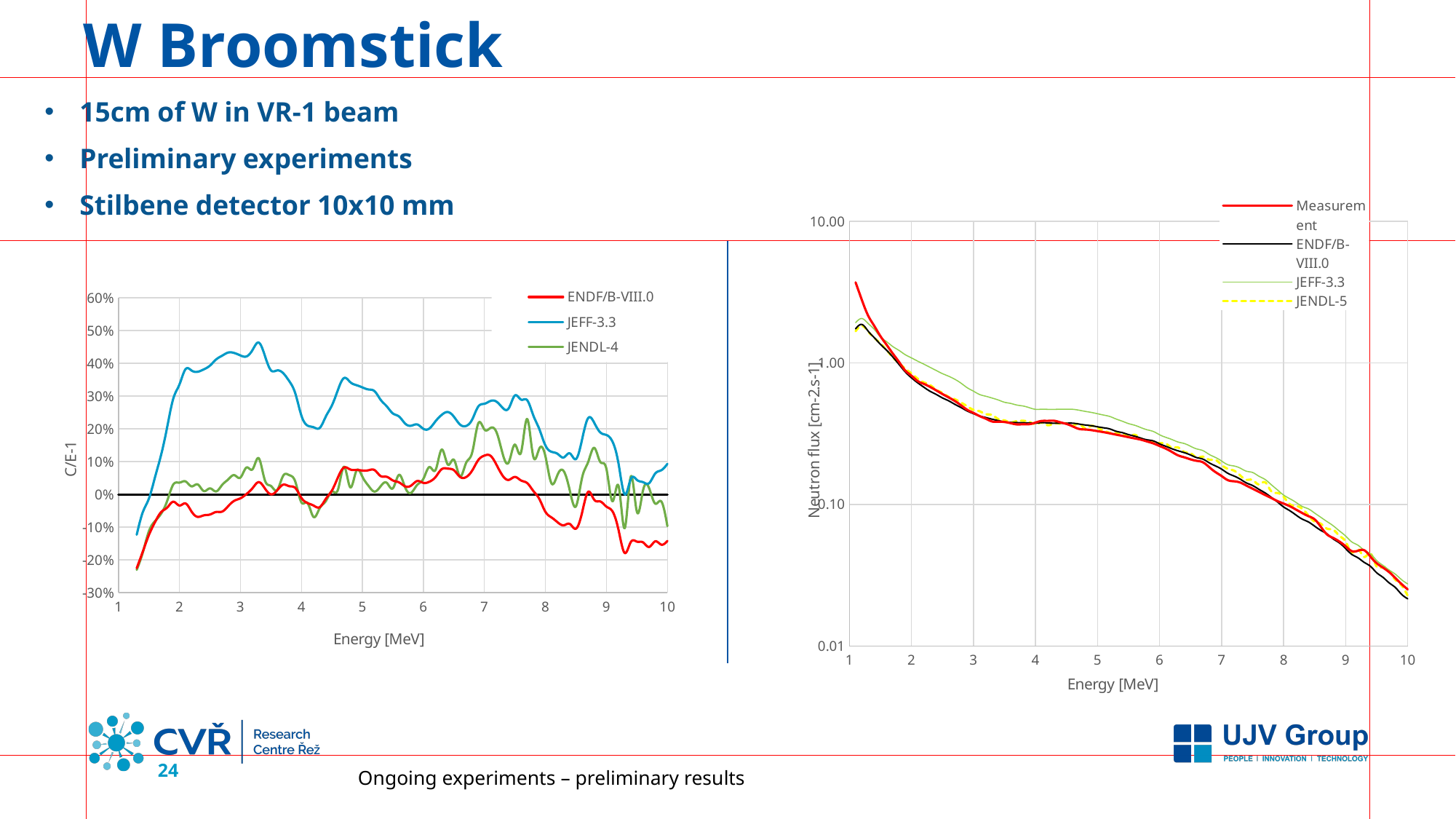
In the left chart (C/E-1), which series has the highest values over most of the energy range? JEFF-3.3 What is the y-axis title of the left chart? C/E-1 In the right chart (Neutron flux), at 5 MeV, which is larger: JEFF-3.3 or Measurement? JEFF-3.3 In the right chart (Neutron flux), is the Measurement value at 10 MeV greater or less than 0.10? less What kind of chart is the left chart with the C/E-1 axis? line chart In the left chart (C/E-1), is the ENDF/B-VIII.0 value at 10 MeV greater or less than 0%? less In the right chart (Neutron flux), do the values rise or fall as energy increases from 1 to 10 MeV? fall What is the x-axis title of the right chart (Neutron flux)? Energy [MeV] In the left chart (C/E-1), at 3 MeV, which is larger: JEFF-3.3 or ENDF/B-VIII.0? JEFF-3.3 In the left chart (C/E-1), is the JEFF-3.3 value at 3 MeV greater or less than 30%? greater How many series does the legend of the right chart (Neutron flux) list? 4 How many series does the legend of the left chart (C/E-1) list? 3